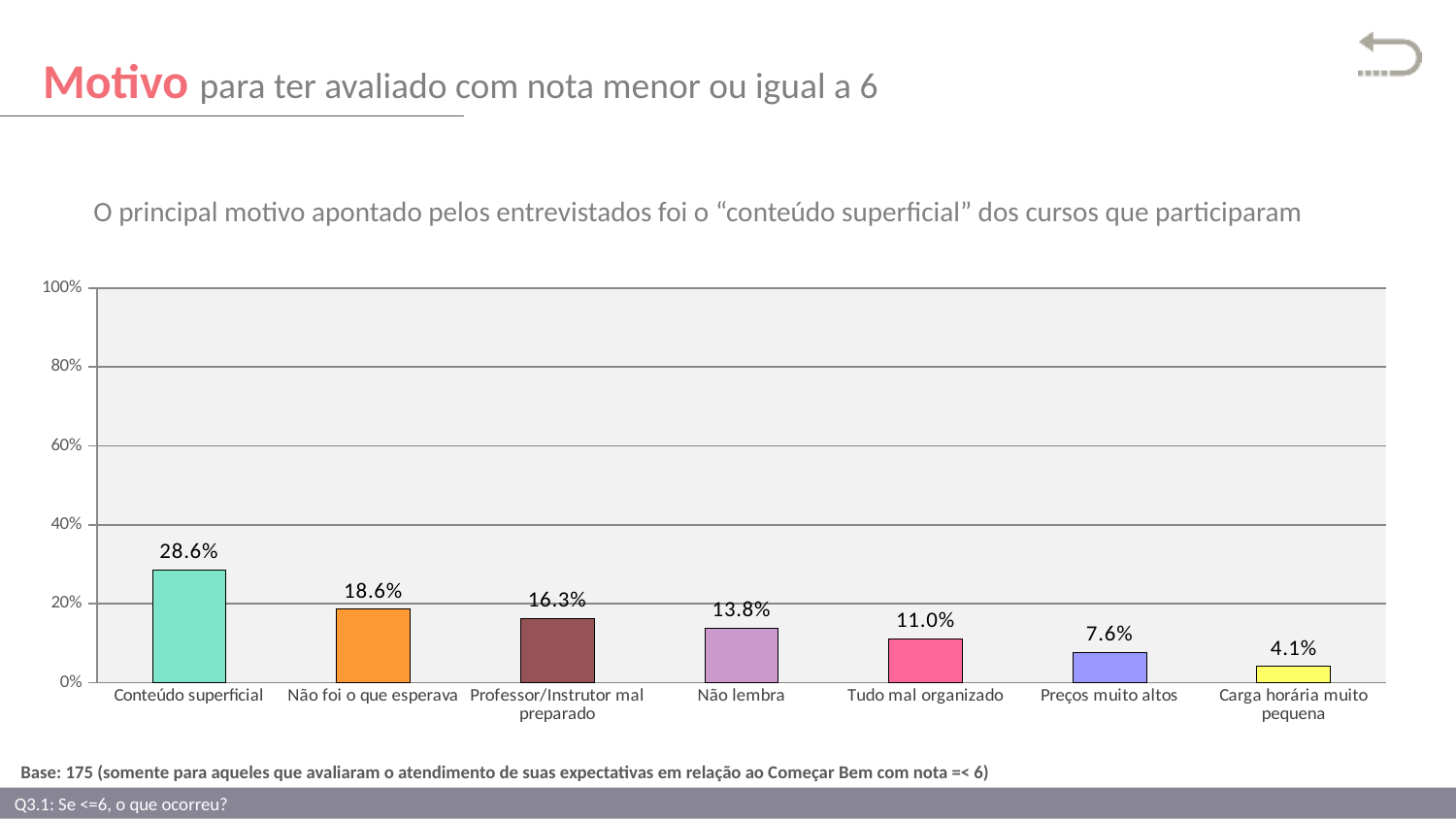
What is the value for "Carga horária muito pequena"? 4.1% Which category has the highest value? Conteúdo superficial Which category has the lowest value? Carga horária muito pequena What is the difference between "Conteúdo superficial" and "Não foi o que esperava"? 10.0% What kind of chart is shown on the slide? bar chart What is the value for "Não lembra"? 13.8% What is the value for "Conteúdo superficial"? 28.6% How many categories are shown in the chart? 7 Do the values rise or fall from left to right along the x axis? fall Which is larger, "Tudo mal organizado" or "Preços muito altos"? Tudo mal organizado What is the base (number of respondents) stated below the chart? 175 Is the value for "Professor/Instrutor mal preparado" greater or less than 20%? less